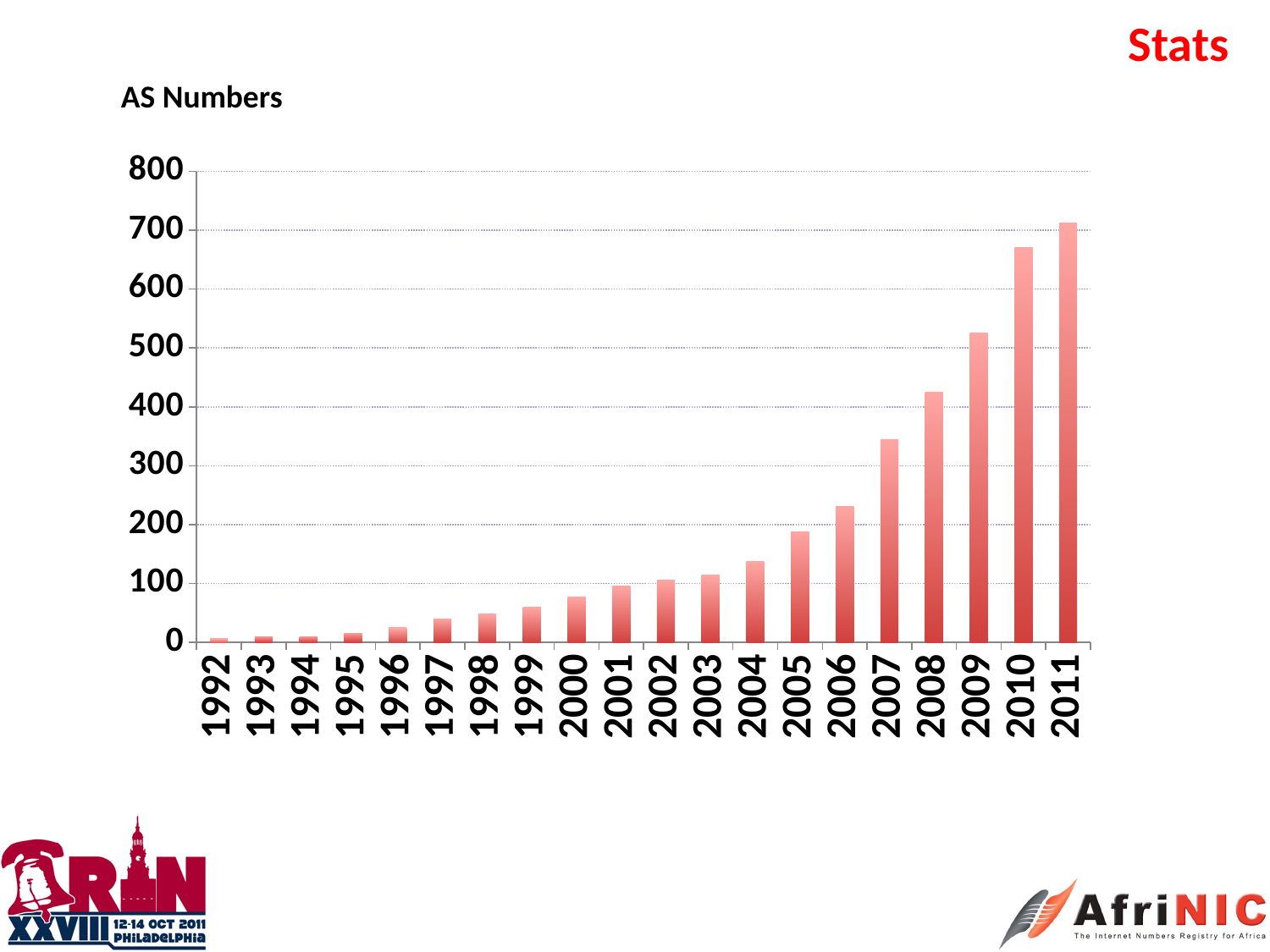
Which year has the highest value in the chart? 2011 How many years are shown on the x axis of the chart? 20 Is the value for 2006 greater or less than 200? greater Is the value for 2009 greater or less than 500? greater Which year has the larger value, 2008 or 2005? 2008 Is the value for 2011 greater or less than 700? greater What is the title of the chart? AS Numbers Which year has the lowest value in the chart? 1992 Do the values generally rise or fall from 1992 to 2011? rise What type of chart is shown on the slide? bar chart